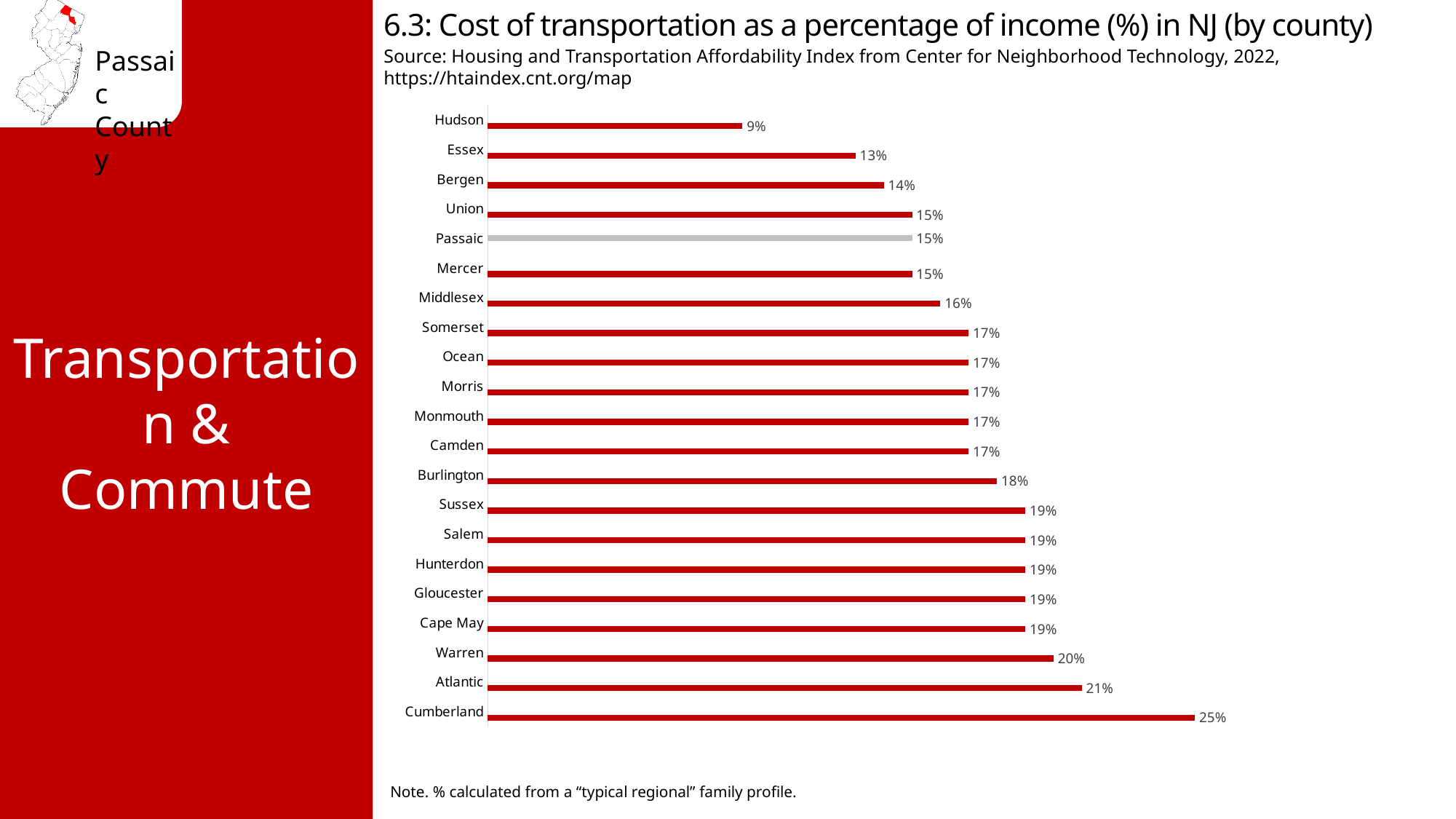
Which has a higher value, Atlantic or Warren? Atlantic How many counties are shown in the chart? 21 What is the cost of transportation as a percentage of income for Passaic County? 15% What kind of chart is shown on the slide? Bar chart Which county has the highest cost of transportation as a percentage of income? Cumberland What is the value shown for Hudson County? 9% What is the difference in percentage points between Cumberland and Hudson? 16 percentage points What is the value shown for Burlington County? 18% What is the value shown for Cumberland County? 25% What is the difference in percentage points between Atlantic and Passaic? 6 percentage points Which county's bar is shown in grey instead of red? Passaic Which county has the lowest cost of transportation as a percentage of income? Hudson